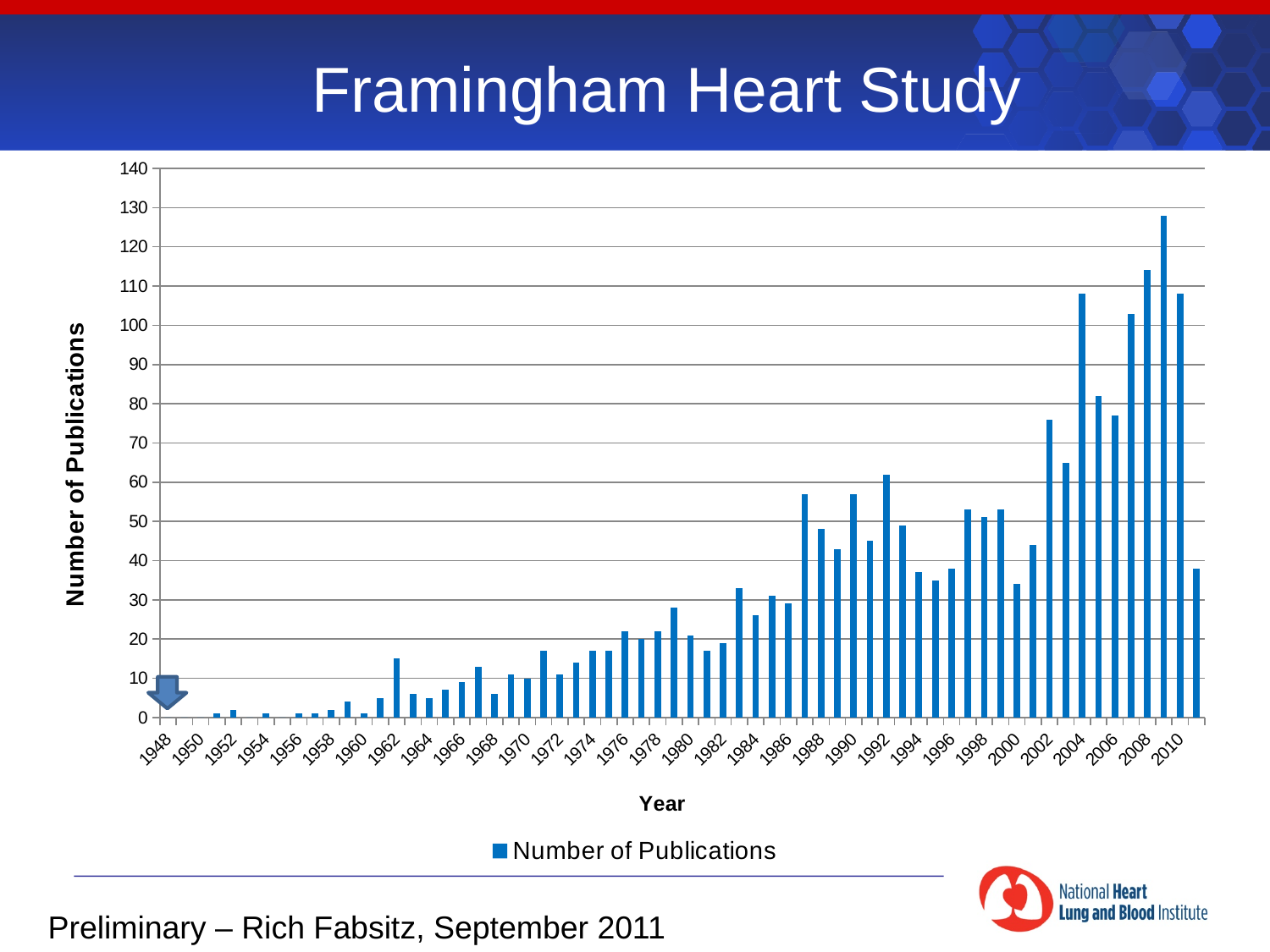
Is the number of publications for 2007 greater or less than 110? less How many series does the legend list? 1 What is the title of the vertical axis? Number of Publications Is the number of publications for 2009 greater or less than 120? greater Is the number of publications for 2003 greater or less than 100? less What kind of chart is shown on the slide? bar chart Overall, do the number of publications rise or fall from 1948 to 2009? rise Which year has the highest number of publications? 2009 Which year has more publications, 2009 or 2010? 2009